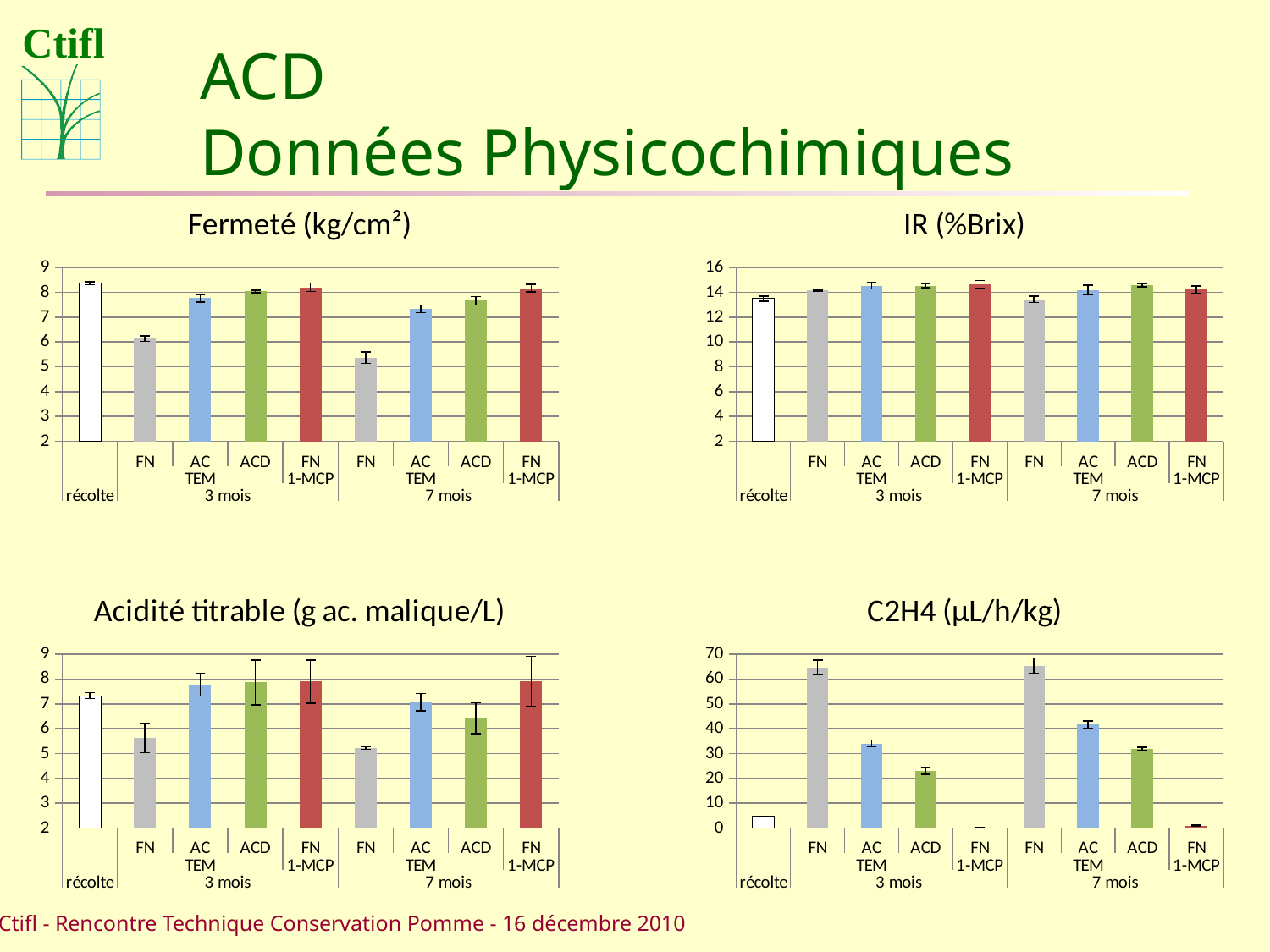
In the C2H4 (µL/h/kg) chart, is the value for récolte greater or less than 10? less In the Fermeté (kg/cm²) chart, which is larger: the value for FN at 7 mois or the value for FN 1-MCP at 7 mois? FN 1-MCP at 7 mois In the Fermeté (kg/cm²) chart, is the value for récolte greater or less than 8? greater In the C2H4 (µL/h/kg) chart, which is larger: the value for ACD at 3 mois or the value for ACD at 7 mois? ACD at 7 mois In the Fermeté (kg/cm²) chart, is the value for FN at 3 mois greater or less than 7? less What kind of chart is the IR (%Brix) chart? bar chart In the Acidité titrable (g ac. malique/L) chart, which is larger: the value for FN at 3 mois or the value for AC TEM at 3 mois? AC TEM at 3 mois How many bars are plotted in the C2H4 (µL/h/kg) chart? 9 In the Fermeté (kg/cm²) chart, which category has the lowest value? FN at 7 mois